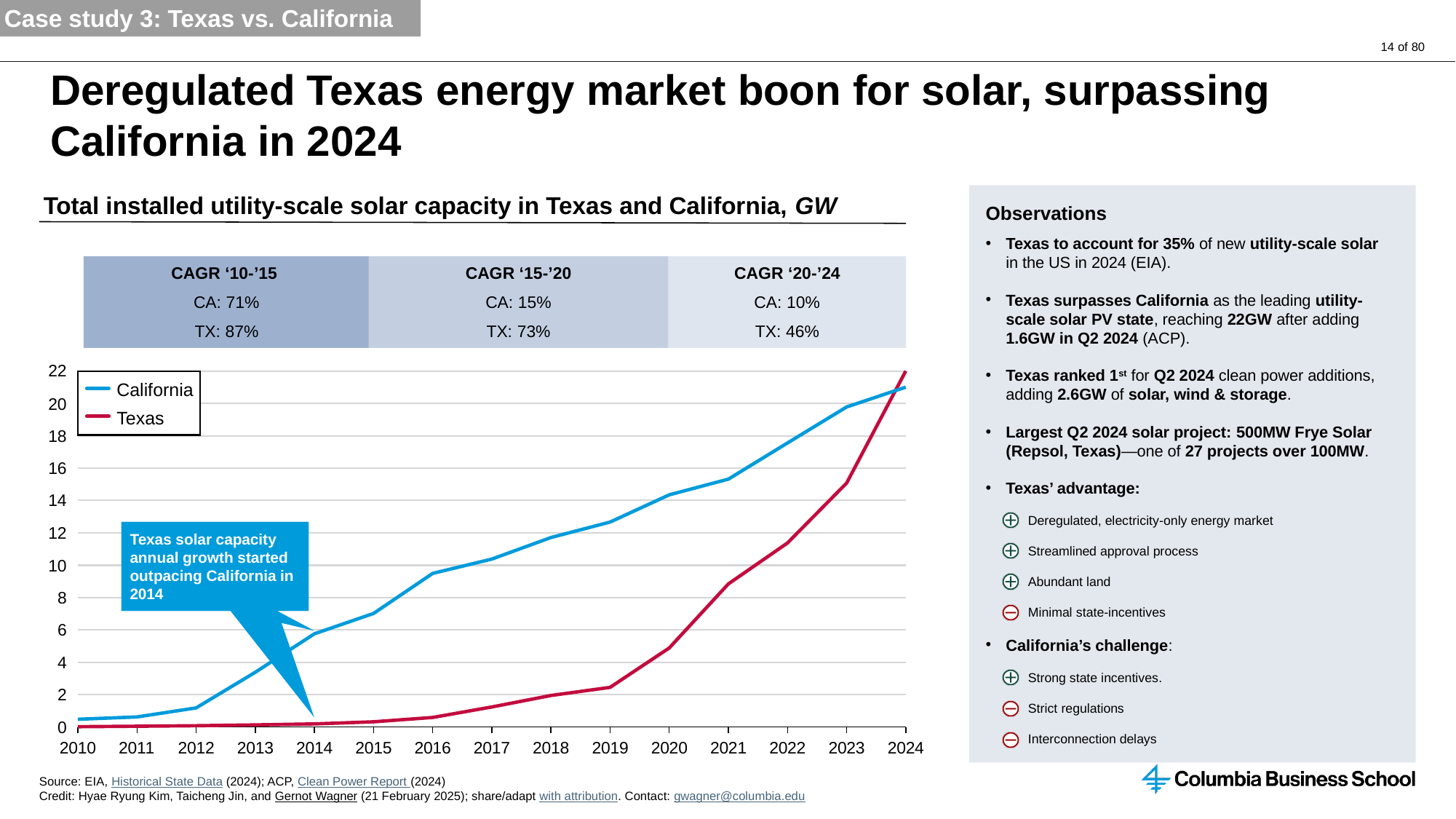
Is California's installed solar capacity in 2012 greater or less than 2 GW? less How many years are shown on the x axis of the solar capacity chart? 15 In 2024, which state had the higher installed utility-scale solar capacity, California or Texas? Texas In 2020, which state had the higher installed utility-scale solar capacity, California or Texas? California Does California's installed solar capacity rise or fall from 2010 to 2024? Rises Is Texas's installed solar capacity in 2019 greater or less than 4 GW? less How many series does the legend of the solar capacity chart list? 2 Is Texas's installed solar capacity in 2022 greater or less than 10 GW? greater What kind of chart is used to show total installed utility-scale solar capacity in Texas and California? Line chart According to the table above the chart, what was Texas's CAGR for 2010-2015? 87% Which colour is used for the Texas line in the solar capacity chart? Red